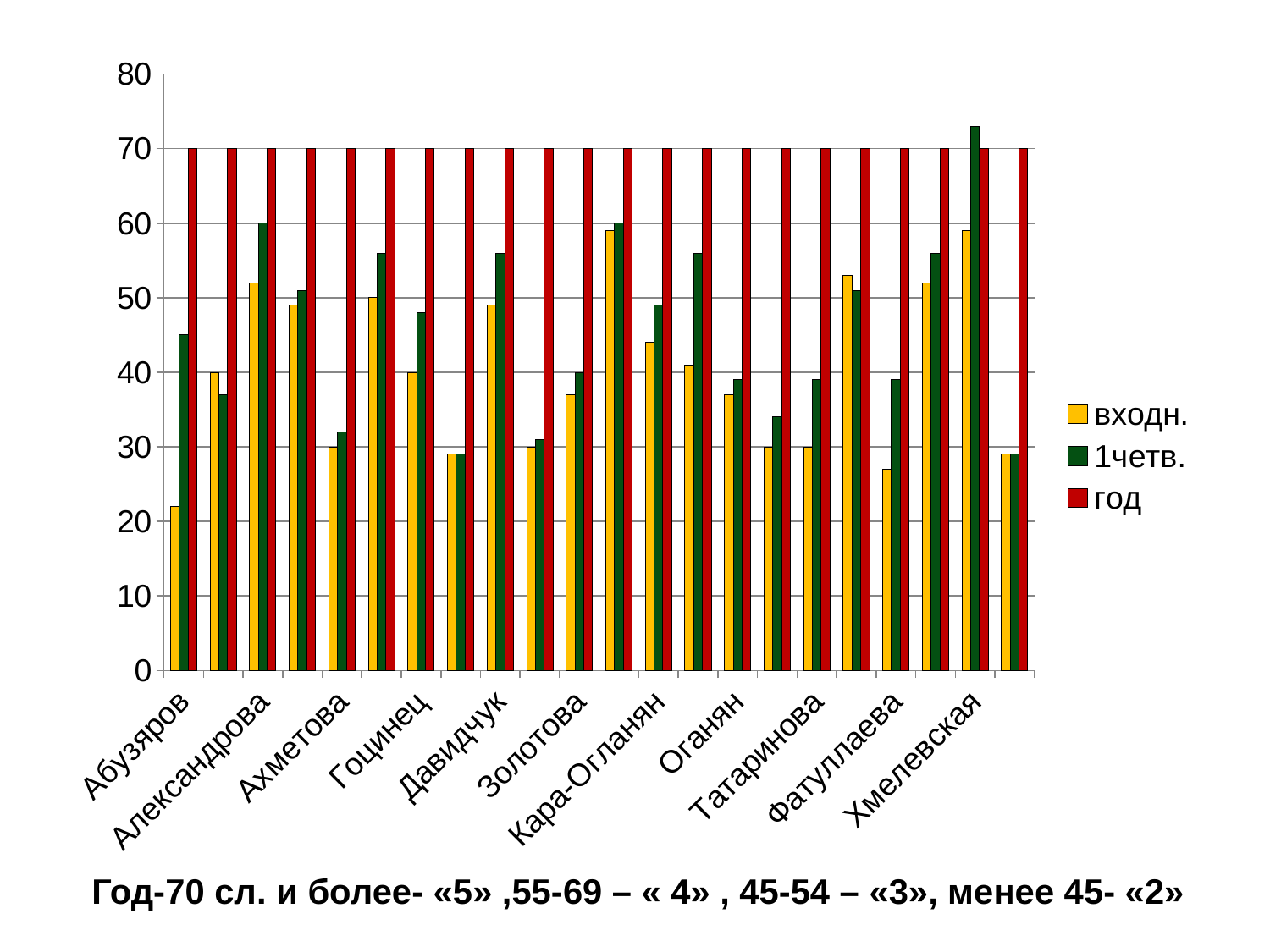
How many series does the legend list? 3 What is the value of "год" for Хмелевская? 70 Which category has the highest value for "1четв."? Хмелевская For Абузяров, which is larger: "входн." or "1четв."? 1четв. Is the value of "1четв." for Хмелевская greater or less than 70? greater Is the value of "входн." for Абузяров greater or less than 30? less What is the value of "год" for Абузяров? 70 Which category has the lowest value for "входн."? Абузяров What kind of chart is shown on the slide? bar chart Which colour represents the series "год"? red What are the series names listed in the legend? входн., 1четв., год Is the value of "1четв." for Абузяров greater or less than 40? greater